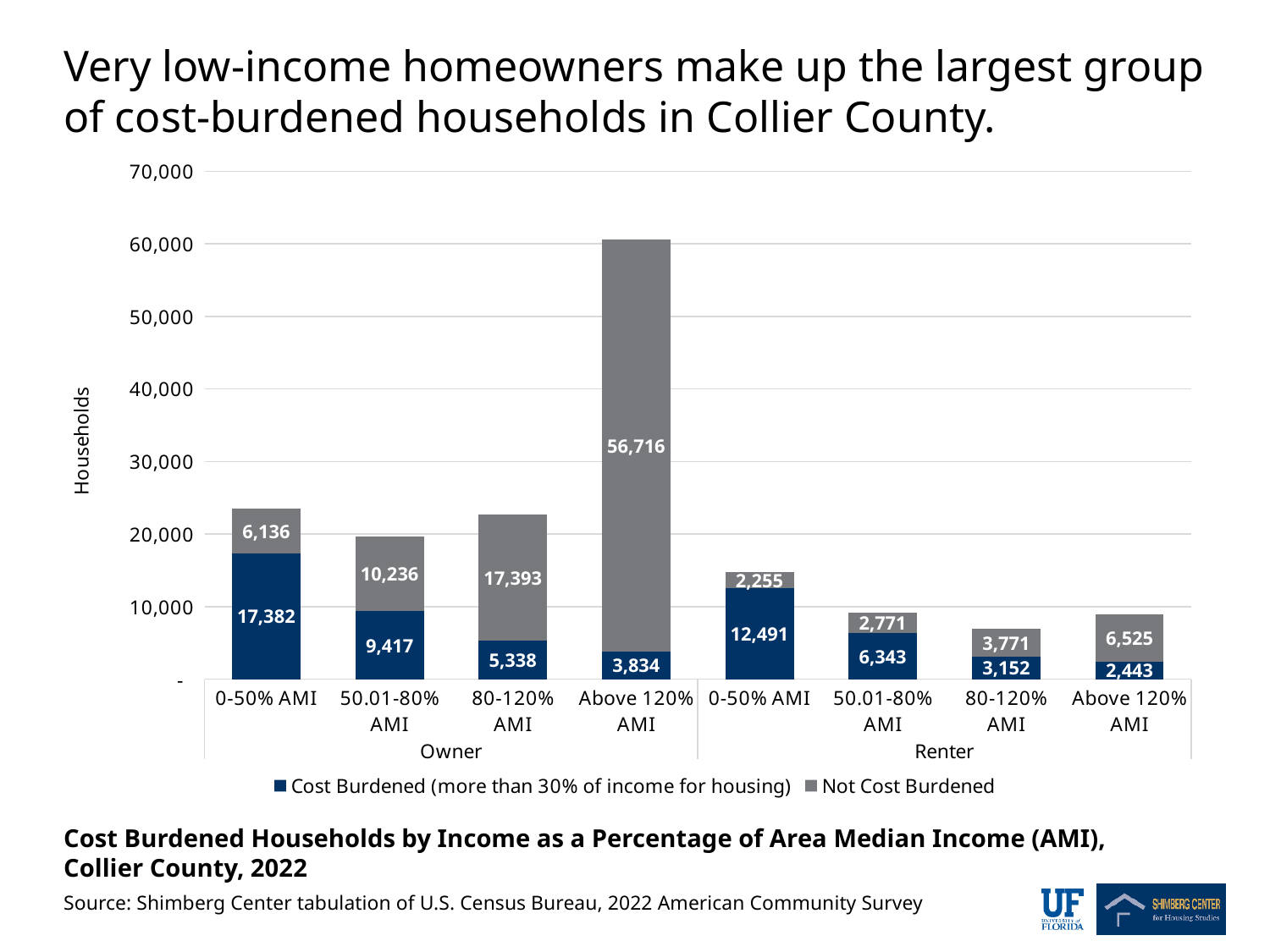
How many series does the legend list? 2 Which category has the smallest number of cost-burdened households? Renter, Above 120% AMI Is the total height of the Owner Above 120% AMI bar greater or less than 50,000? greater How many cost-burdened renter households are in the 50.01-80% AMI group? 6,343 How many income categories are shown in total across the Owner and Renter groups? 8 How many not-cost-burdened owner households are in the Above 120% AMI group? 56,716 Which is larger: the number of cost-burdened owner households at 50.01-80% AMI or the number of not-cost-burdened owner households at 50.01-80% AMI? Not Cost Burdened (10,236) What is the difference between cost-burdened owner households and cost-burdened renter households in the 0-50% AMI group? 4,891 What is the total number of owner households in the 0-50% AMI group (cost burdened plus not cost burdened)? 23,518 Which category has the largest number of cost-burdened households? Owner, 0-50% AMI What kind of chart is shown on the slide? Stacked bar chart How many cost-burdened owner households are in the 0-50% AMI group? 17,382